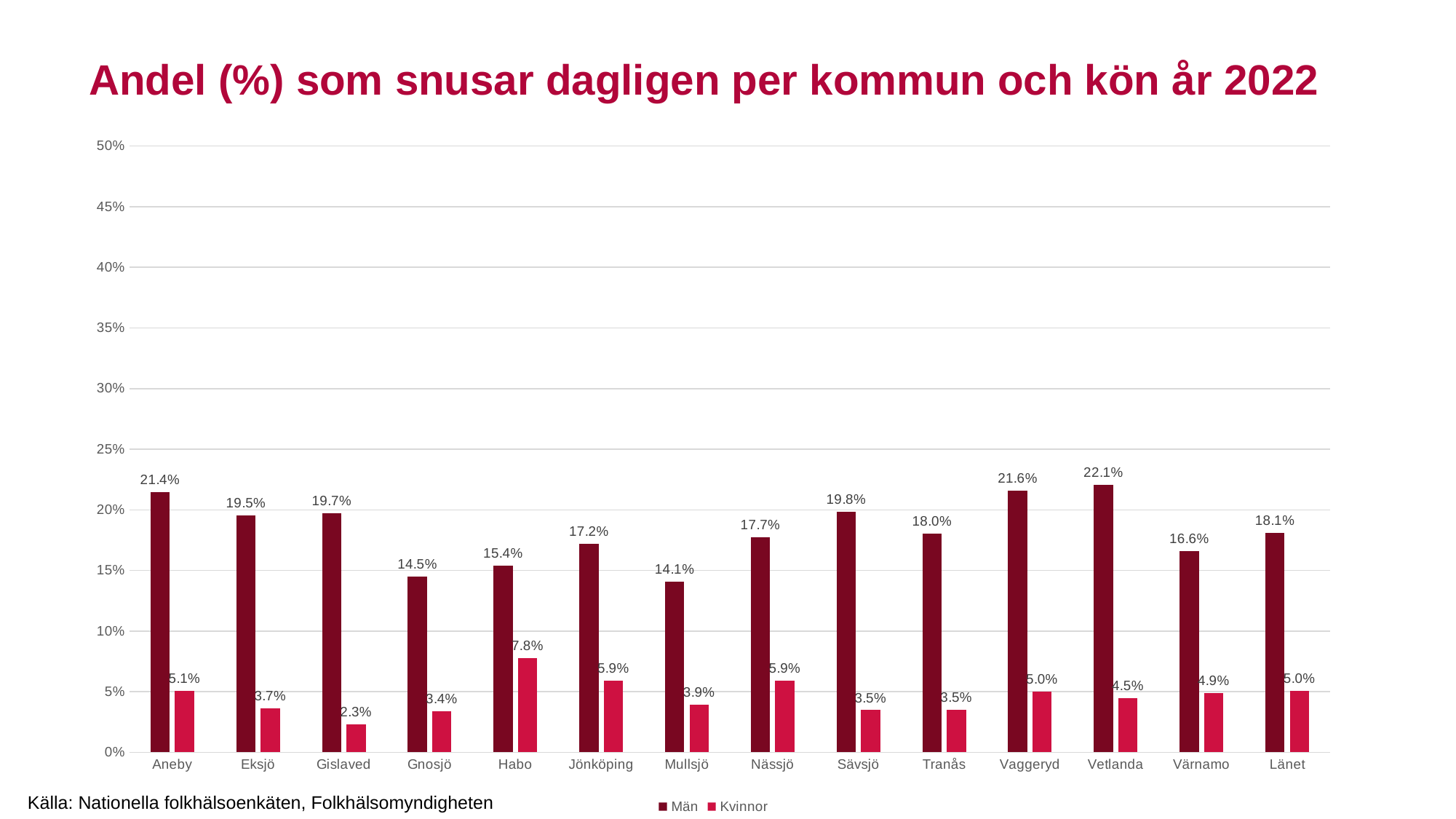
What is the value for Män in Vetlanda? 22.1% What is the value for Män in Länet? 18.1% Is the value for Män in Gnosjö greater or less than 15%? less Which municipality has the lowest value for Män? Mullsjö What kind of chart is shown on the slide? Bar chart Which municipality has the lowest value for Kvinnor? Gislaved What is the difference between the Män and Kvinnor values in Aneby? 16.3% How many municipalities/categories are shown on the x axis? 14 What is the value for Kvinnor in Habo? 7.8% Which municipality has the highest value for Män? Vetlanda How many series does the legend list? 2 Which is larger: the Kvinnor value for Jönköping or for Eksjö? Jönköping